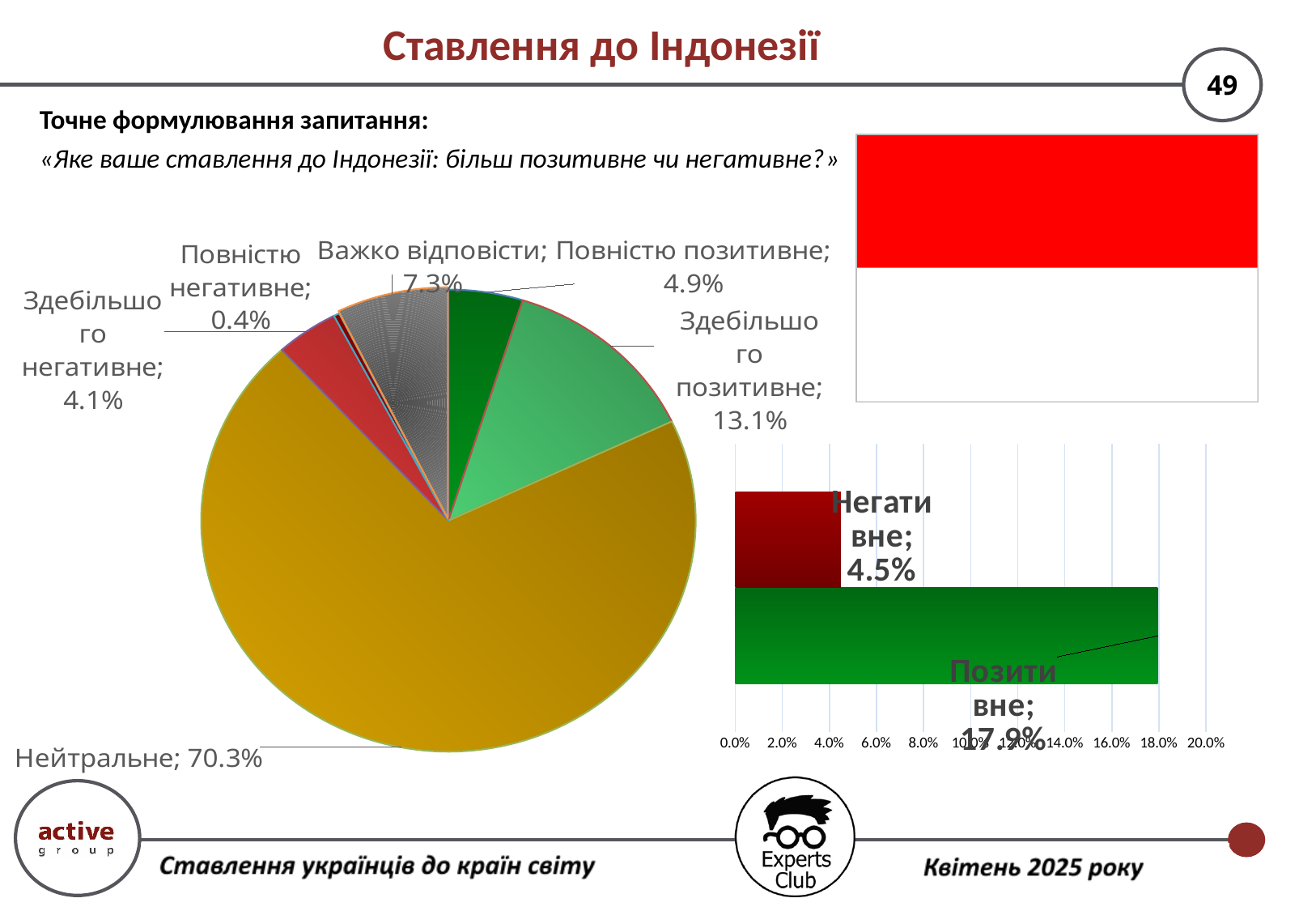
How many slices does the pie chart have? 6 In the pie chart, what is the difference between Здебільшого позитивне and Повністю позитивне? 8.2% In the bar chart on the right, what is the value for Негативне? 4.5% In the pie chart, what share is labelled for Повністю негативне? 0.4% In the bar chart on the right, what is the value for Позитивне? 17.9% In the pie chart, which is larger: Повністю позитивне or Здебільшого негативне? Повністю позитивне In the pie chart, what share is labelled for Здебільшого позитивне? 13.1% In the pie chart, which category has the largest slice? Нейтральне In the pie chart, what share is labelled for Важко відповісти? 7.3% In the pie chart, which category has the smallest slice? Повністю негативне In the pie chart, what share is labelled for Нейтральне? 70.3% In the bar chart on the right, what is the difference between Позитивне and Негативне? 13.4%